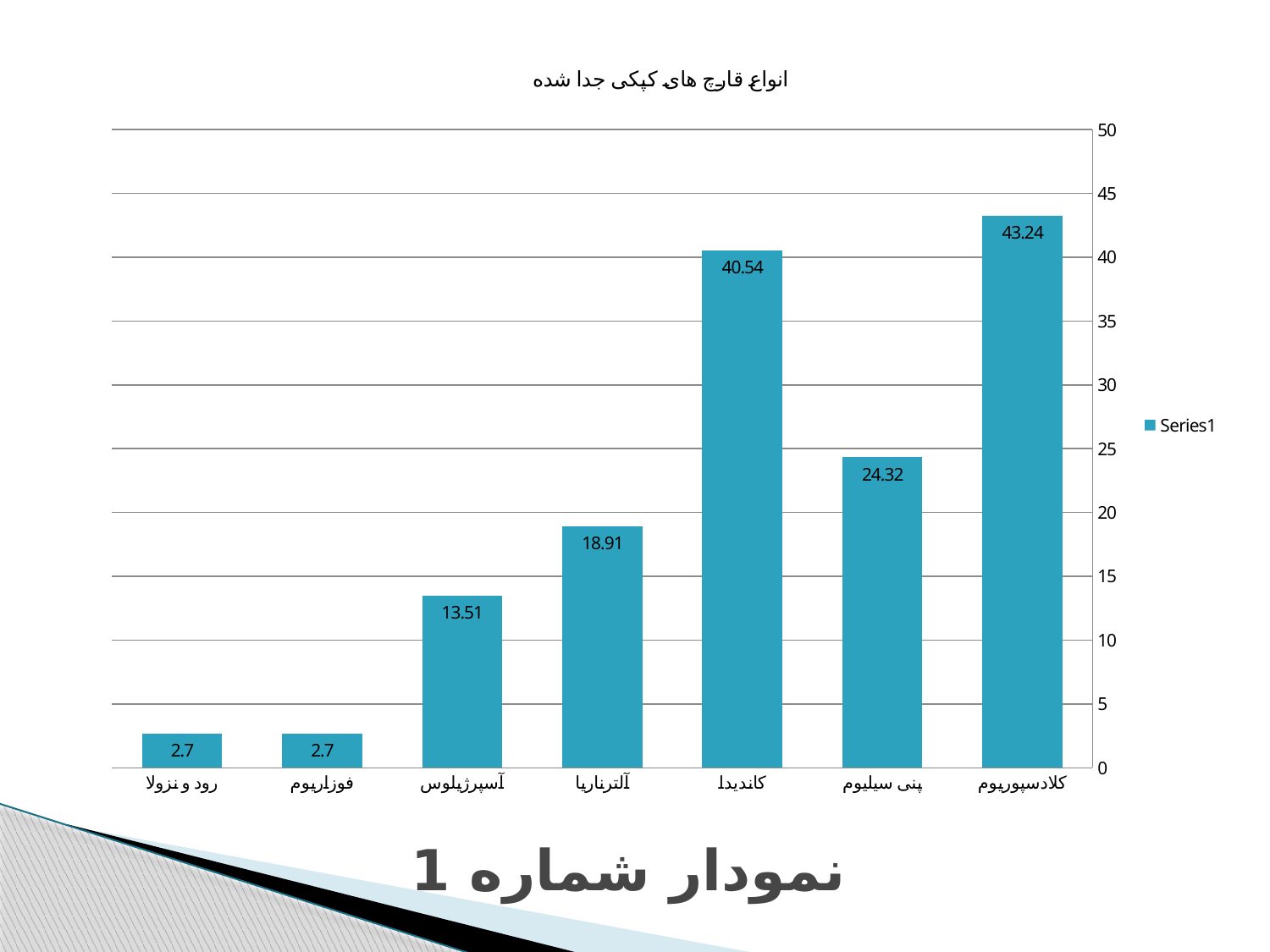
Which is larger, the value for آلترناریا or the value for آسپرژیلوس? آلترناریا What is the value for پنی سیلیوم? 24.32 Which category has the highest value? کلادسپوریوم How many categories are shown on the x axis? 7 What is the title of the chart? انواع قارچ های کپکی جدا شده Is the value for پنی سیلیوم greater or less than 20? greater What is the value for آسپرژیلوس? 13.51 What is the difference between the values for پنی سیلیوم and آلترناریا? 5.41 How many series does the legend list? 1 What kind of chart is shown on the slide? bar chart What is the value for کاندیدا? 40.54 What is the difference between the values for کلادسپوریوم and کاندیدا? 2.7